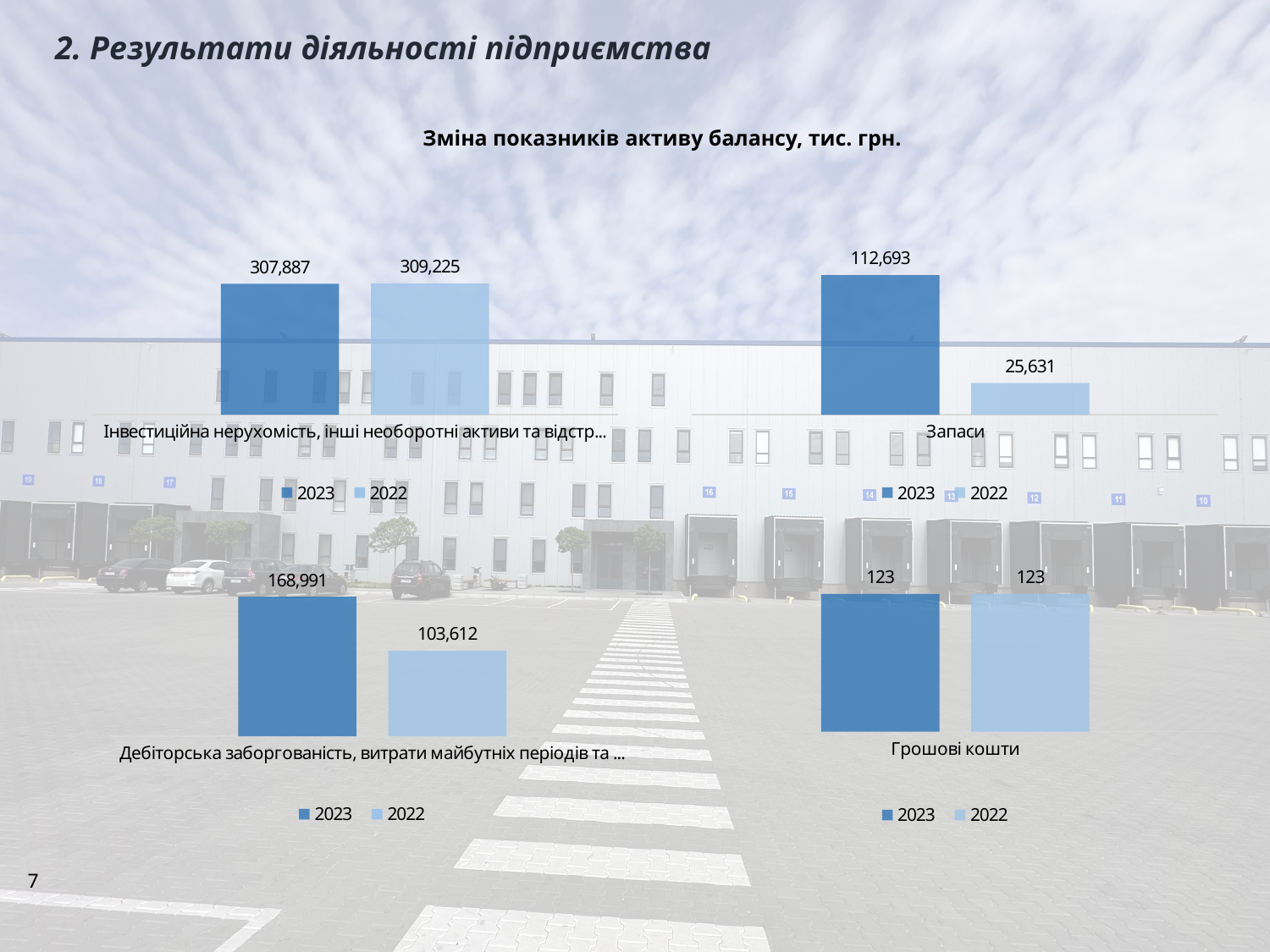
What is the overall title shown above the charts on the slide? Зміна показників активу балансу, тис. грн. In the top-right chart (Запаси), what is the value for 2023? 112,693 In the bottom-right chart (Грошові кошти), what is the value for 2022? 123 What type of chart is the top-right chart (Запаси)? Bar chart In the bottom-right chart (Грошові кошти), how many series does the legend list? 2 In the top-right chart (Запаси), what is the difference between the 2023 and 2022 values? 87,062 In the top-right chart (Запаси), what is the value for 2022? 25,631 In the bottom-left chart (Дебіторська заборгованість...), what is the value for 2023? 168,991 In the top-left chart (Інвестиційна нерухомість...), what is the value for 2022? 309,225 In the bottom-left chart (Дебіторська заборгованість...), what is the difference between the 2023 and 2022 values? 65,379 In the top-left chart (Інвестиційна нерухомість...), what is the difference between the 2022 and 2023 values? 1,338 In the bottom-left chart (Дебіторська заборгованість...), which year has the larger value, 2023 or 2022? 2023